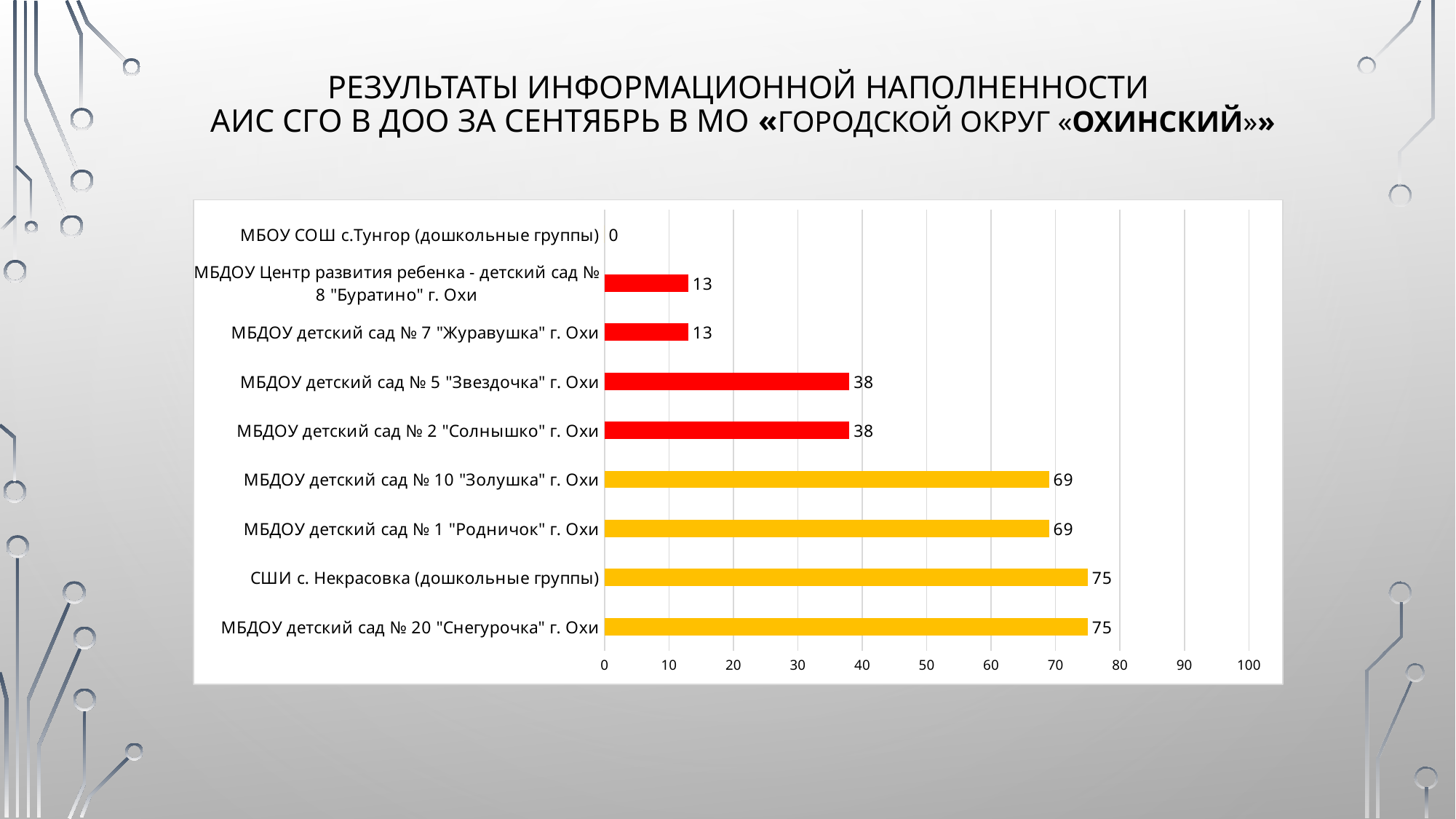
Which has a larger value: МБДОУ детский сад № 1 "Родничок" г. Охи or МБДОУ Центр развития ребенка - детский сад № 8 "Буратино" г. Охи? МБДОУ детский сад № 1 "Родничок" г. Охи What colour are the bars for the organisations with values of 69 and 75? yellow What is the value for МБДОУ детский сад № 7 "Журавушка" г. Охи? 13 What is the value for СШИ с. Некрасовка (дошкольные группы)? 75 What is the value for МБДОУ детский сад № 5 "Звездочка" г. Охи? 38 What is the difference between the values for МБДОУ детский сад № 20 "Снегурочка" г. Охи and МБДОУ детский сад № 2 "Солнышко" г. Охи? 37 What is the value for МБДОУ детский сад № 10 "Золушка" г. Охи? 69 Is the value for МБДОУ детский сад № 2 "Солнышко" г. Охи greater or less than 50? less What type of chart is shown on the slide? bar chart What is the highest value shown in the chart? 75 Which organisation has the lowest value in the chart? МБОУ СОШ с.Тунгор (дошкольные группы) How many organisations (categories) are shown in the chart? 9